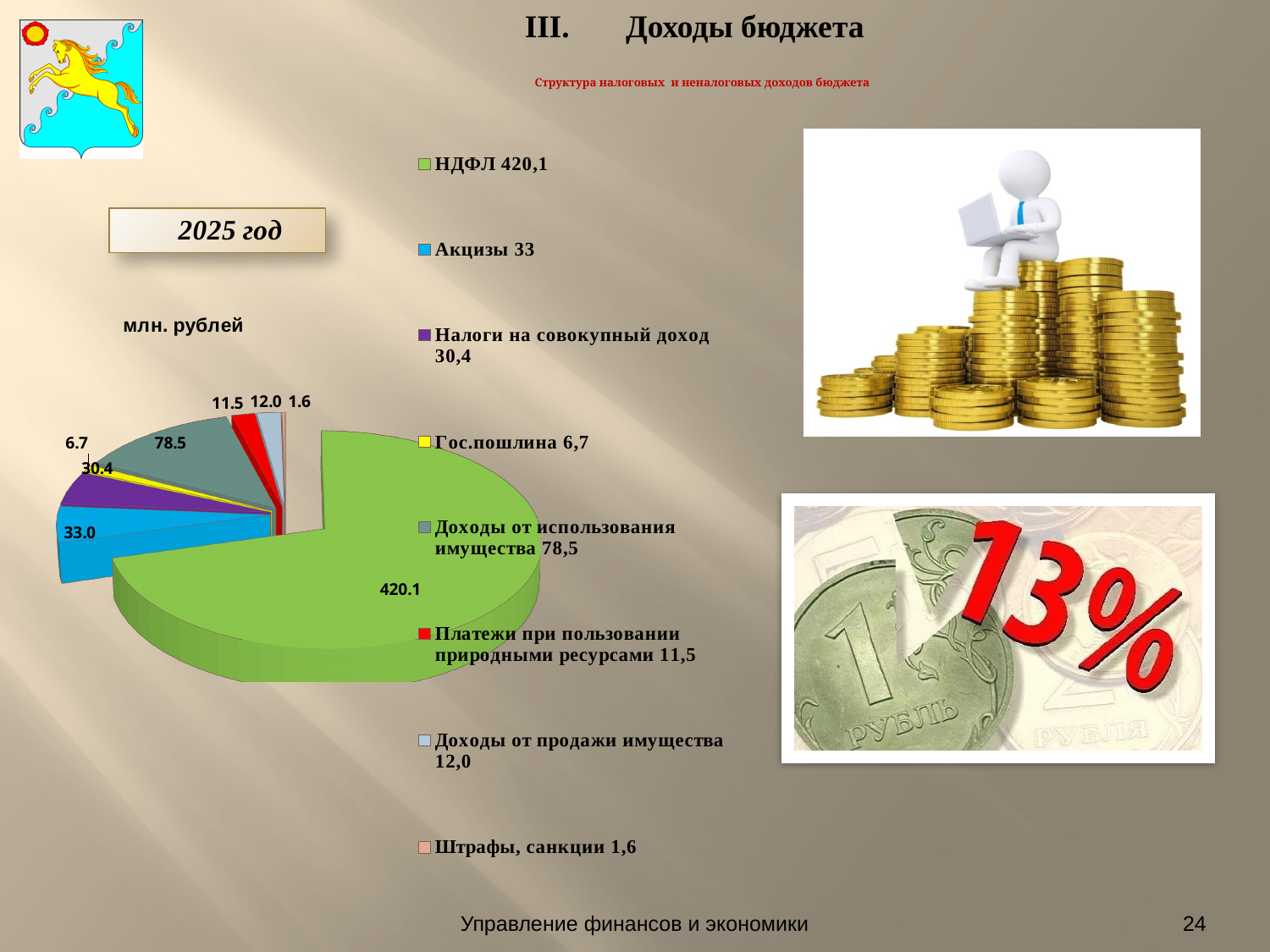
What is the value for Акцизы in the pie chart? 33.0 What is the value for НДФЛ in the pie chart? 420.1 Which category has the smallest slice of the pie chart? Штрафы, санкции What kind of chart is shown on the slide? pie chart Which category has the largest slice of the pie chart? НДФЛ What is the difference between the values for НДФЛ and Доходы от использования имущества? 341.6 What is the difference between Доходы от продажи имущества and Платежи при пользовании природными ресурсами? 0.5 Which is larger: Акцизы or Налоги на совокупный доход? Акцизы What unit is stated above the pie chart? млн. рублей How many categories does the pie chart have? 8 What is the value for Платежи при пользовании природными ресурсами? 11.5 What is the value for Доходы от использования имущества? 78.5